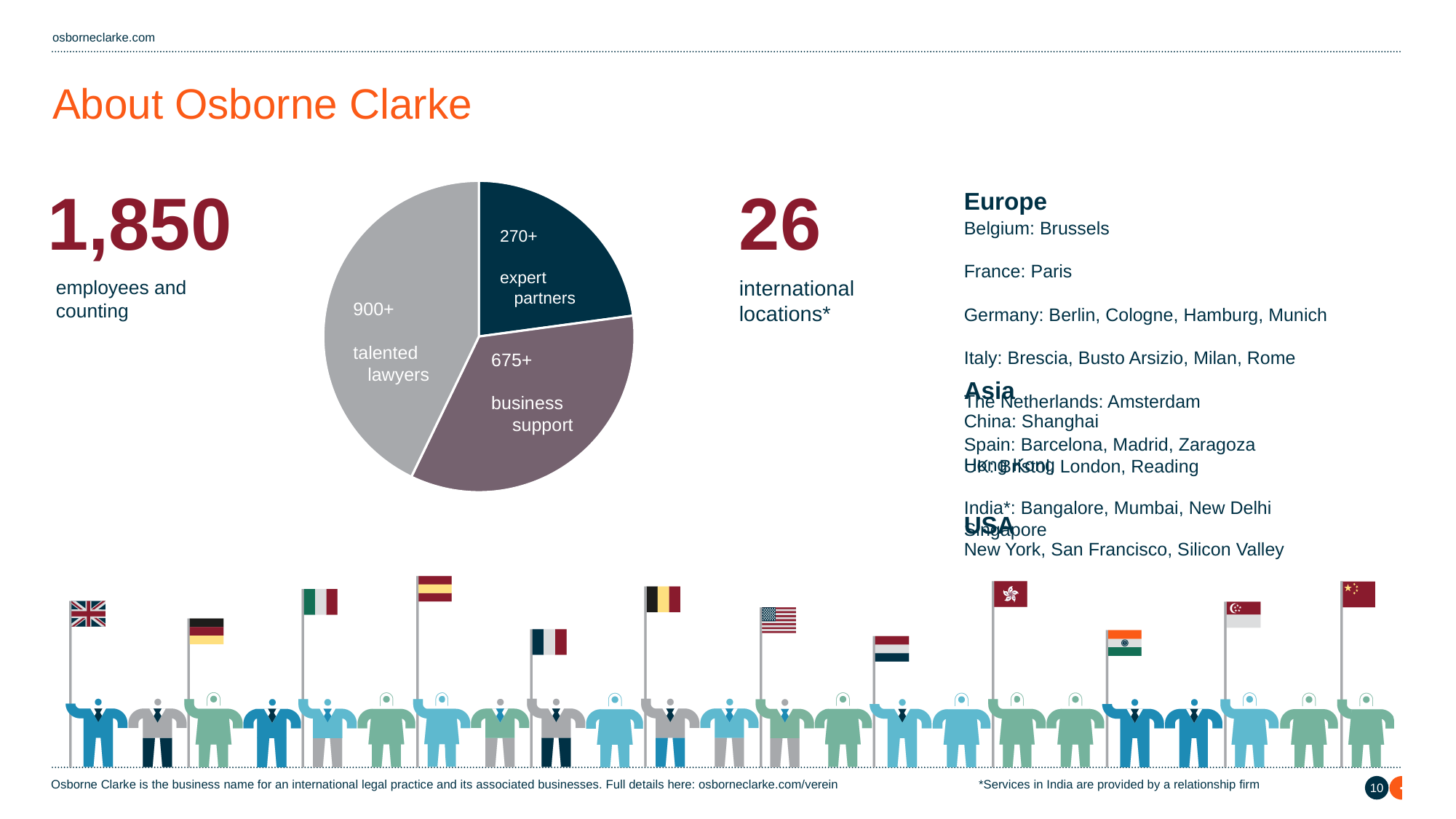
Which is larger in the pie chart: talented lawyers or business support? talented lawyers What value is shown for the expert partners slice of the pie chart? 270+ Which slice of the pie chart is the largest? talented lawyers What kind of chart is shown on the slide? pie chart What value is shown for the business support slice of the pie chart? 675+ What value is shown for the talented lawyers slice of the pie chart? 900+ What colour is the expert partners slice of the pie chart? dark teal Which slice of the pie chart is the smallest? expert partners Which is larger in the pie chart: business support or expert partners? business support What colour is the talented lawyers slice of the pie chart? grey How many slices does the pie chart have? 3